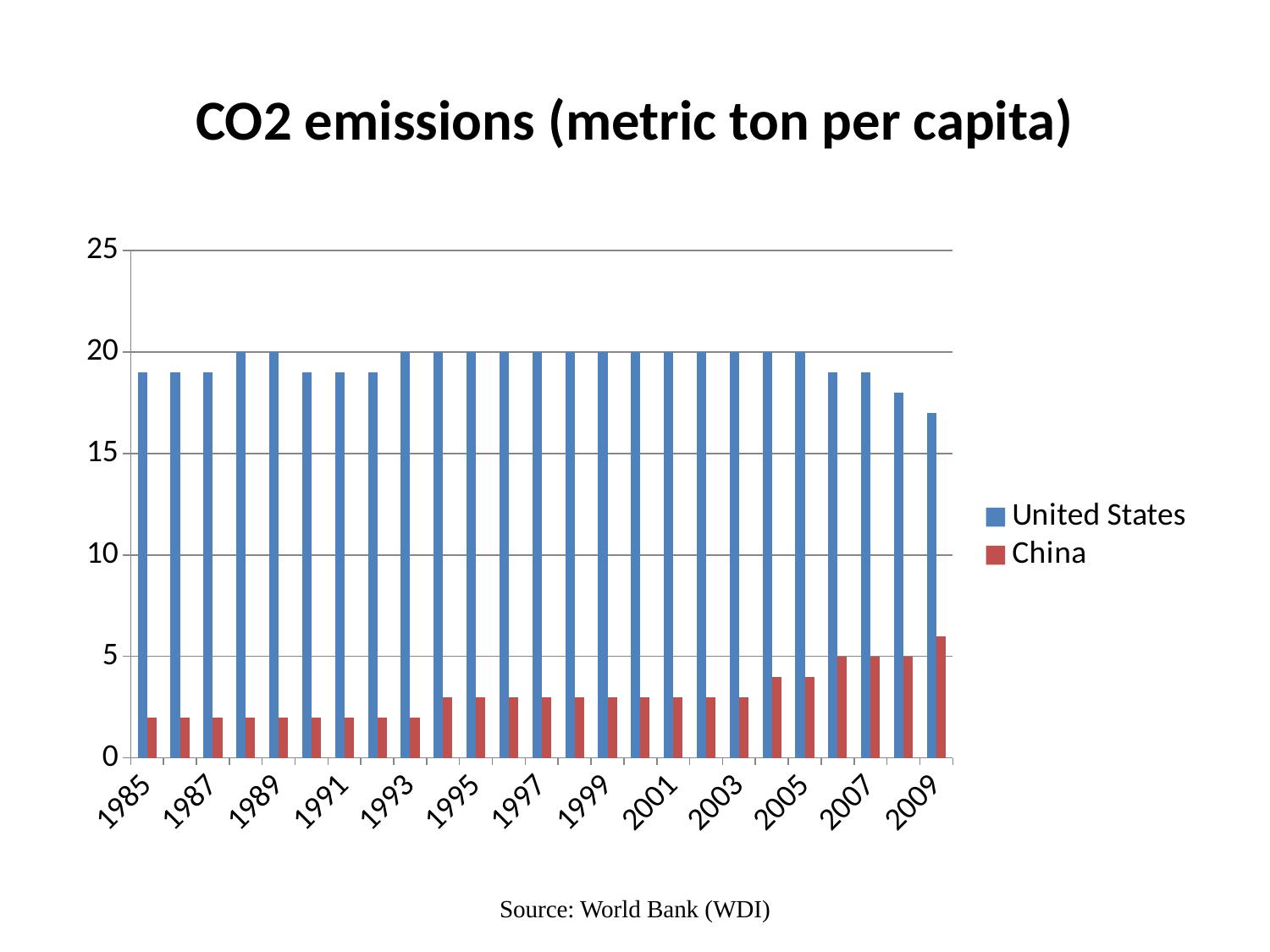
Which colour represents China in the chart? red Is the value for United States in 2009 greater or less than 20? less Is the value for United States in 1985 greater or less than 15? greater In which year is the value for United States lowest? 2009 Is the value for China in 2009 greater or less than 5? greater What kind of chart is shown on the slide? bar chart In which year is the value for China highest? 2009 How many years are plotted along the x axis? 25 How many series does the legend list? 2 What is the title of the chart? CO2 emissions (metric ton per capita) In 2009, which series has the larger value, United States or China? United States